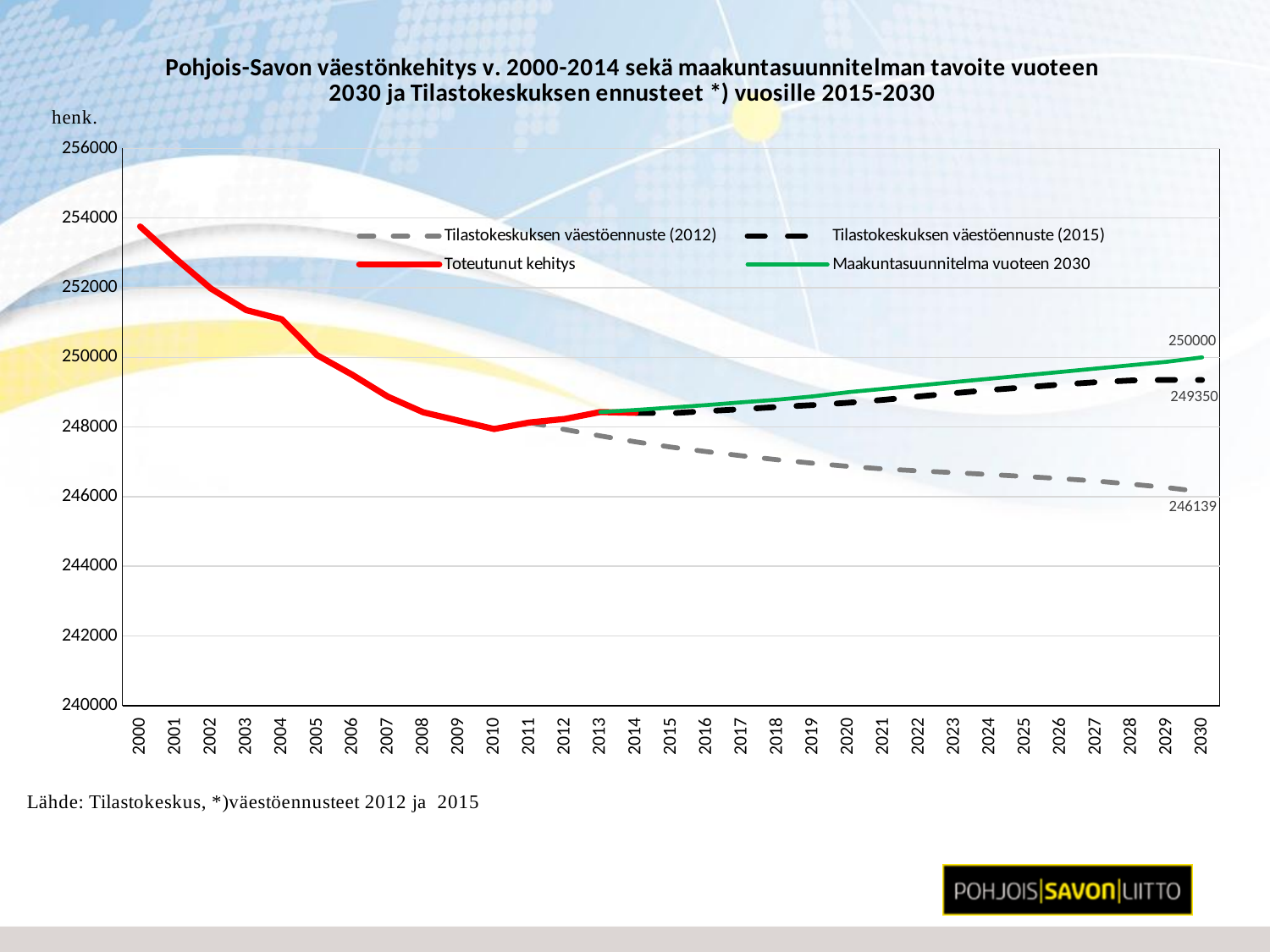
What value is labelled for Tilastokeskuksen väestöennuste (2015) at the year 2030? 249350 At the year 2030, which is larger: Tilastokeskuksen väestöennuste (2015) or Tilastokeskuksen väestöennuste (2012)? Tilastokeskuksen väestöennuste (2015) Is the value for Toteutunut kehitys in 2000 greater or less than 252000? greater What is the difference between the 2030 values of Tilastokeskuksen väestöennuste (2015) and Tilastokeskuksen väestöennuste (2012)? 3211 Which series has the lowest labelled value at the year 2030? Tilastokeskuksen väestöennuste (2012) How many series does the legend list? 4 Is the value for Toteutunut kehitys in 2007 greater or less than 250000? less What value is labelled for Maakuntasuunnitelma vuoteen 2030 at the year 2030? 250000 Which series has the highest labelled value at the year 2030? Maakuntasuunnitelma vuoteen 2030 What value is labelled for Tilastokeskuksen väestöennuste (2012) at the year 2030? 246139 What kind of chart is shown on the slide? line chart What is the difference between the 2030 values of Maakuntasuunnitelma vuoteen 2030 and Tilastokeskuksen väestöennuste (2015)? 650